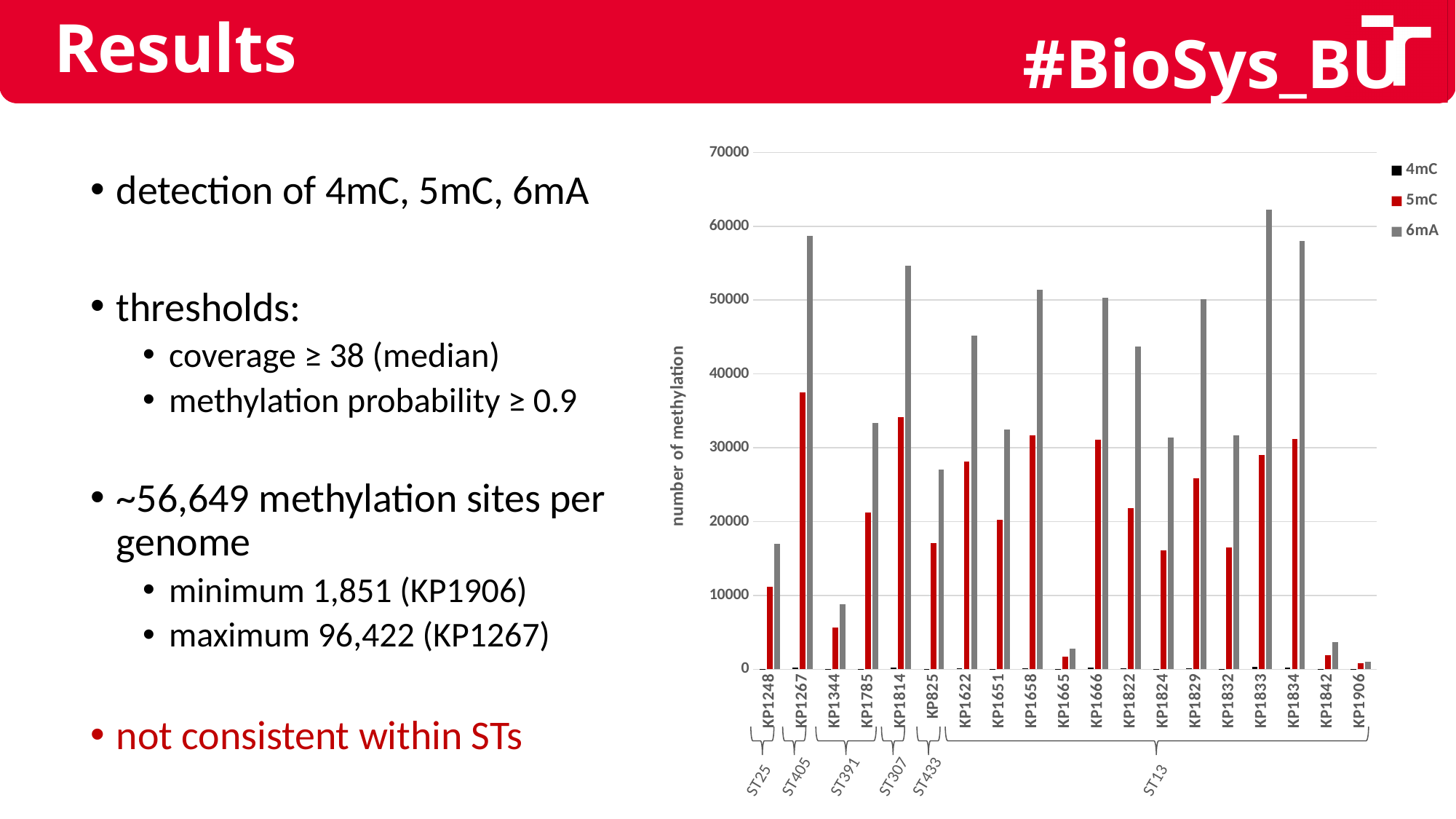
Is the 5mC value for KP1622 greater or less than 20000? greater Is the 6mA value for KP1267 greater or less than 50000? greater How many series does the legend of the chart list? 3 Which isolate has the highest 6mA value in the chart? KP1833 Is the 5mC value for KP1824 greater or less than 20000? less Which is larger: the 6mA value for KP1622 or the 6mA value for KP1651? KP1622 How many KP isolates (categories) are shown on the x axis of the chart? 19 What is the label of the y axis of the chart? number of methylation Which is larger: the 5mC value for KP1267 or the 5mC value for KP1785? KP1267 What kind of chart is shown on the slide? bar chart Which isolate has the highest 5mC value in the chart? KP1267